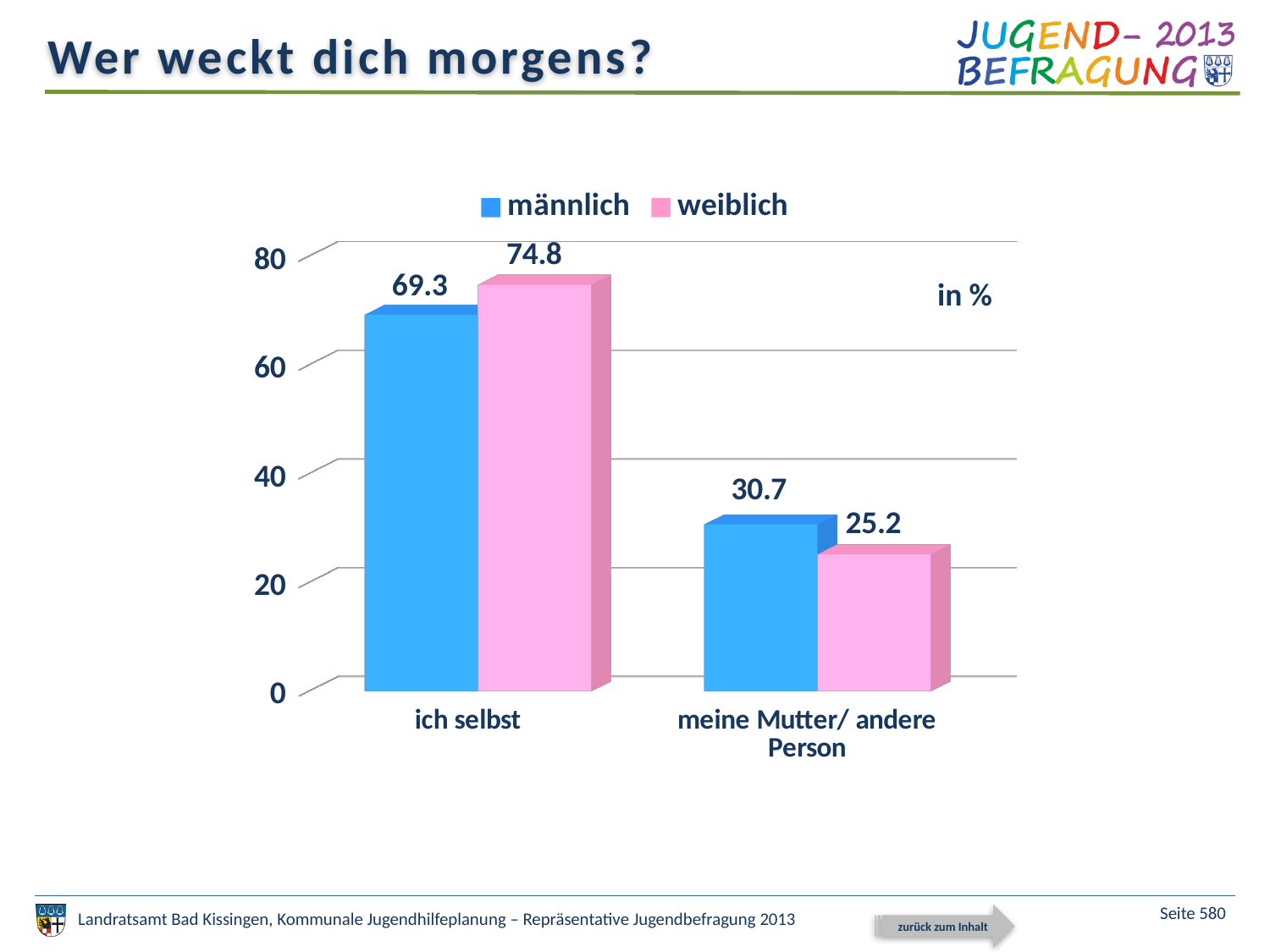
What is the value for männlich in the category "ich selbst"? 69.3 How many series does the legend list? 2 Which category has the highest value for weiblich? ich selbst What is the value for weiblich in the category "meine Mutter/ andere Person"? 25.2 What is the difference between the männlich and weiblich values for "meine Mutter/ andere Person"? 5.5 What is the value for weiblich in the category "ich selbst"? 74.8 How many categories are shown on the x axis? 2 For "meine Mutter/ andere Person", which series has the larger value, männlich or weiblich? männlich What is the value for männlich in the category "meine Mutter/ andere Person"? 30.7 Which category has the lowest value for männlich? meine Mutter/ andere Person What is the difference between the weiblich and männlich values for "ich selbst"? 5.5 What kind of chart is shown on the slide? bar chart